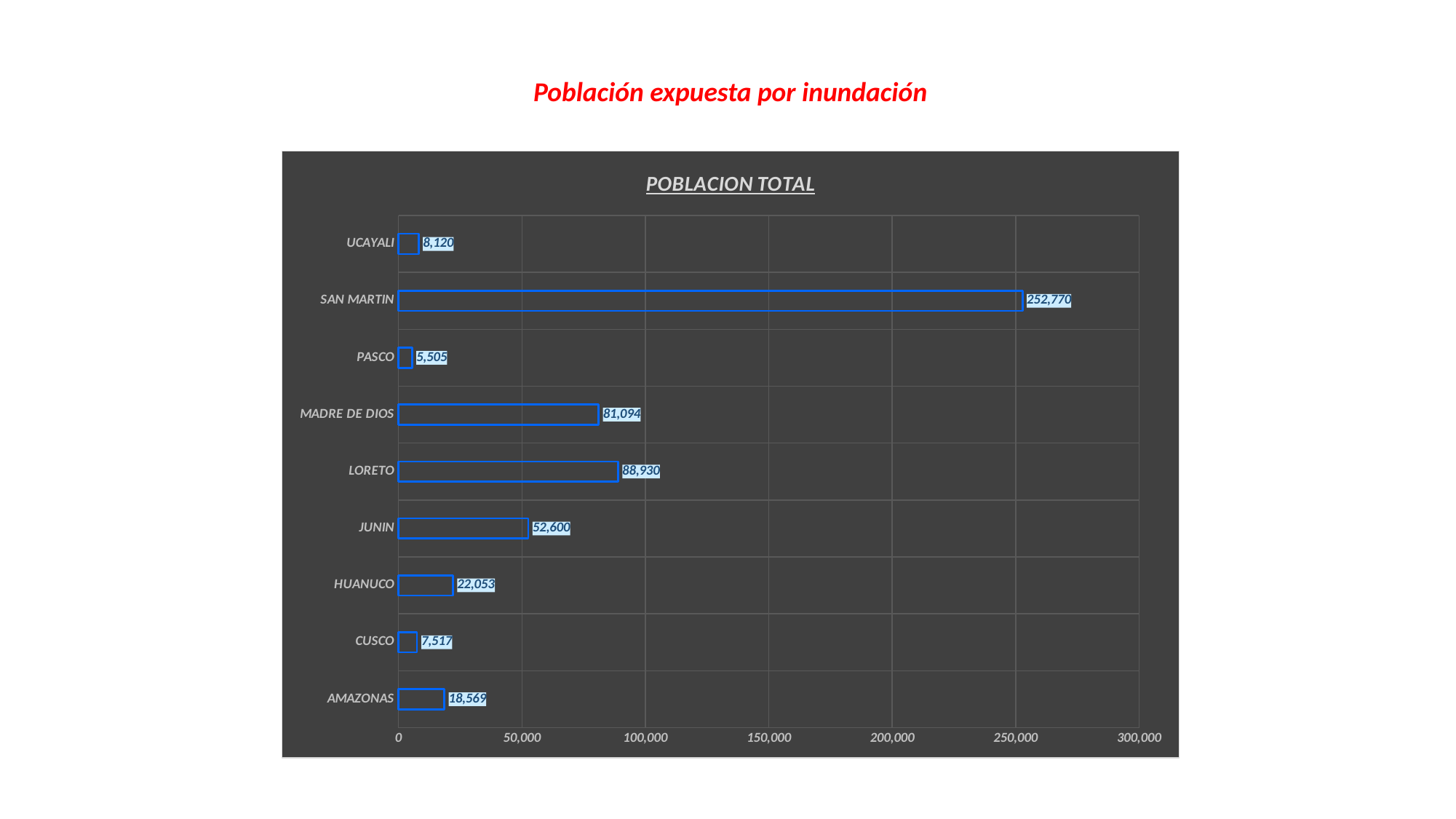
What is the value for AMAZONAS? 18,569 What is the value for SAN MARTIN? 252,770 What is the title of the chart? POBLACION TOTAL Which category has the highest value? SAN MARTIN Is the value for MADRE DE DIOS greater or less than 100,000? less Which is larger, the value for JUNIN or the value for HUANUCO? JUNIN What is the value for LORETO? 88,930 What kind of chart is shown on the slide? bar chart How many categories are shown in the chart? 9 Which category has the lowest value? PASCO What is the difference between the values for UCAYALI and CUSCO? 603 What is the difference between the values for LORETO and MADRE DE DIOS? 7,836